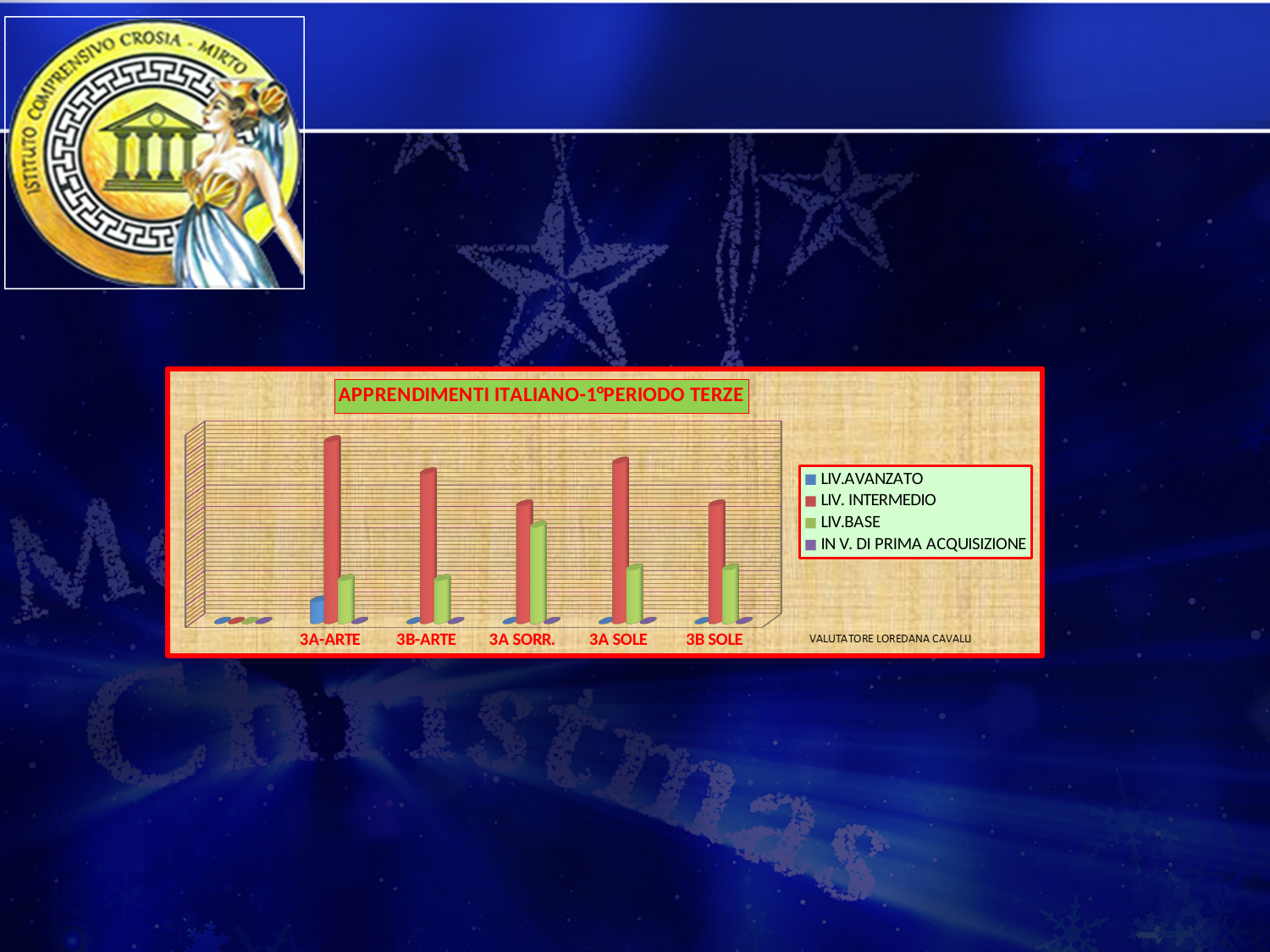
Which category has the tallest LIV.BASE bar? 3A SORR. Is the LIV. INTERMEDIO bar taller for 3A-ARTE or for 3B-ARTE? 3A-ARTE Which category has the tallest LIV. INTERMEDIO bar? 3A-ARTE Which category has the tallest LIV.AVANZATO bar? 3A-ARTE How many categories are shown on the x axis? 5 Is the LIV. INTERMEDIO bar taller for 3A SOLE or for 3B SOLE? 3A SOLE Which legend entry is shown in purple? IN V. DI PRIMA ACQUISIZIONE What is the title of the chart? APPRENDIMENTI ITALIANO-1°PERIODO TERZE How many series does the legend list? 4 What kind of chart is shown on the slide? bar chart Is the LIV.BASE bar taller for 3A SORR. or for 3B-ARTE? 3A SORR.